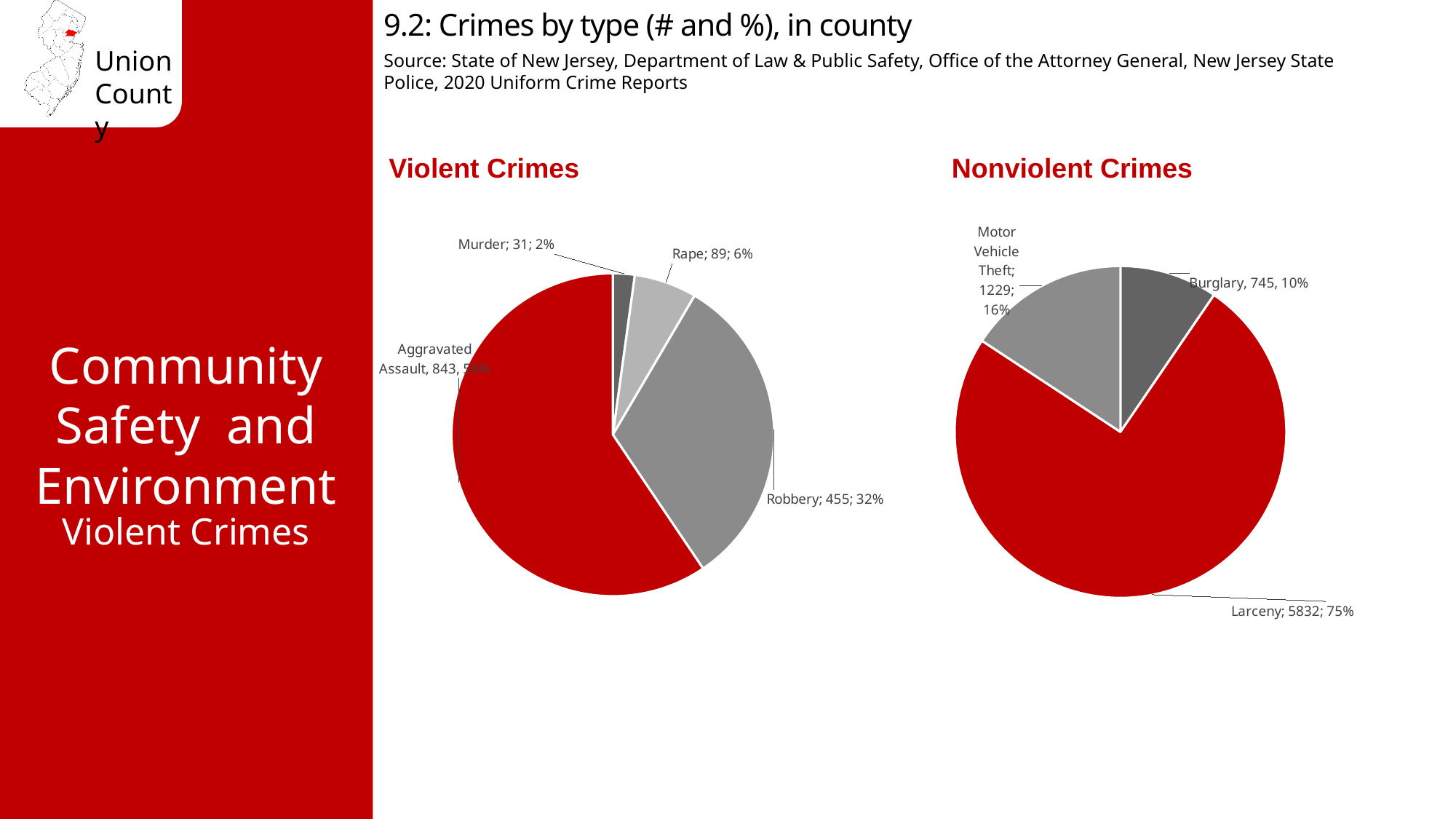
In the Violent Crimes chart, what is the difference between the Aggravated Assault count and the Robbery count? 388 In the Violent Crimes chart, what share of the pie is Rape? 6% In the Violent Crimes chart, how many murders are shown? 31 In the Violent Crimes chart, which category has the smallest slice? Murder In the Nonviolent Crimes chart, what share of the pie is Motor Vehicle Theft? 16% In the Nonviolent Crimes chart, how many larcenies are shown? 5832 What type of chart is the Violent Crimes chart? Pie chart In the Violent Crimes chart, how many robberies are shown? 455 In the Nonviolent Crimes chart, which is larger, Burglary or Motor Vehicle Theft? Motor Vehicle Theft In the Violent Crimes chart, which category has the largest slice? Aggravated Assault How many categories does the Nonviolent Crimes pie chart have? 3 In the Violent Crimes chart, what share of the pie is Robbery? 32%